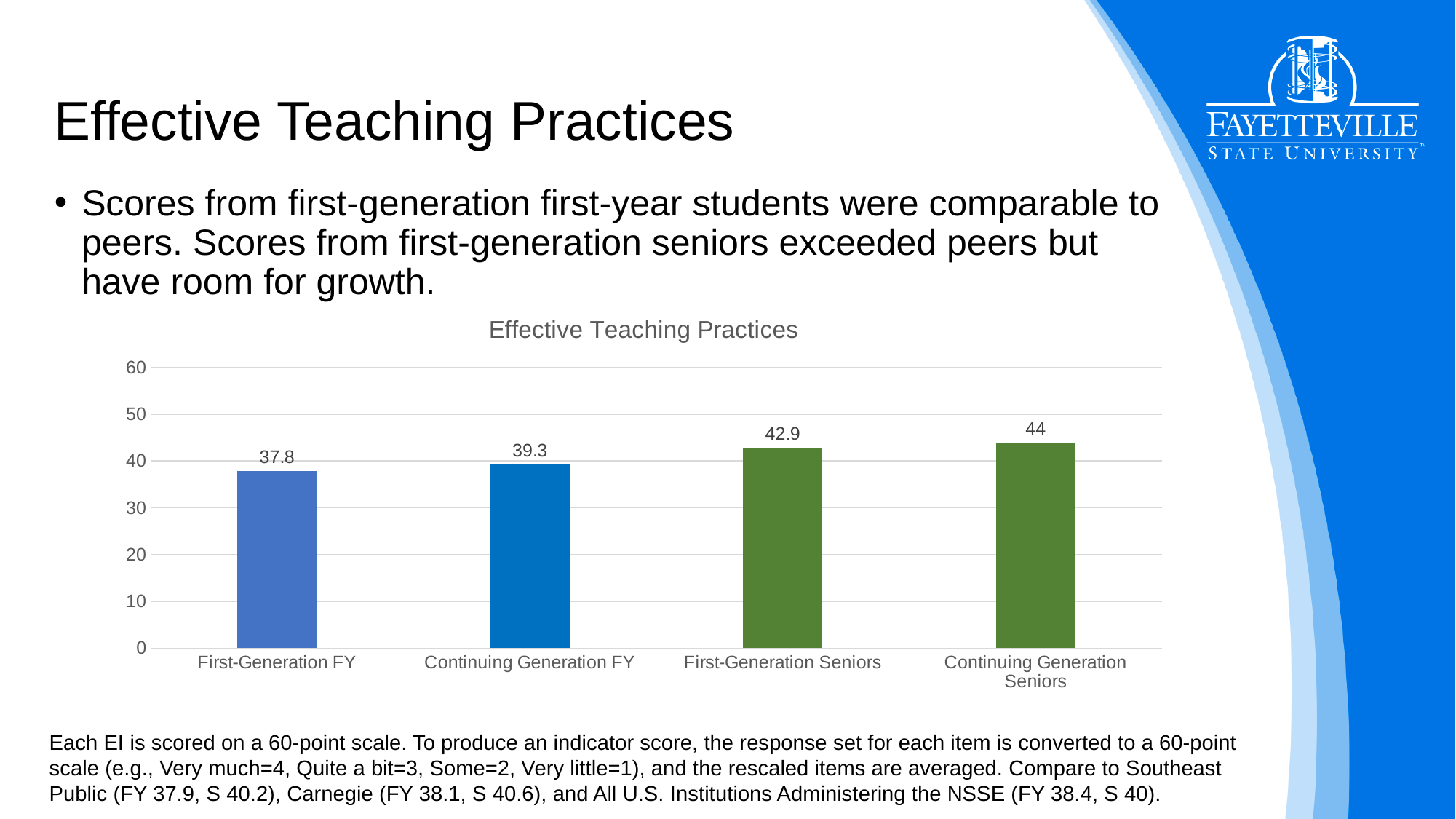
Which category has the highest value? Continuing Generation Seniors How many categories are shown in the chart? 4 What is the difference between Continuing Generation Seniors and First-Generation Seniors? 1.1 What is the difference between Continuing Generation FY and First-Generation FY? 1.5 What is the value for Continuing Generation FY? 39.3 What is the value for First-Generation FY? 37.8 Which category has the lowest value? First-Generation FY Which is larger, First-Generation Seniors or Continuing Generation FY? First-Generation Seniors What kind of chart is shown? Bar chart What is the value for Continuing Generation Seniors? 44 What is the value for First-Generation Seniors? 42.9 What is the title of the chart? Effective Teaching Practices